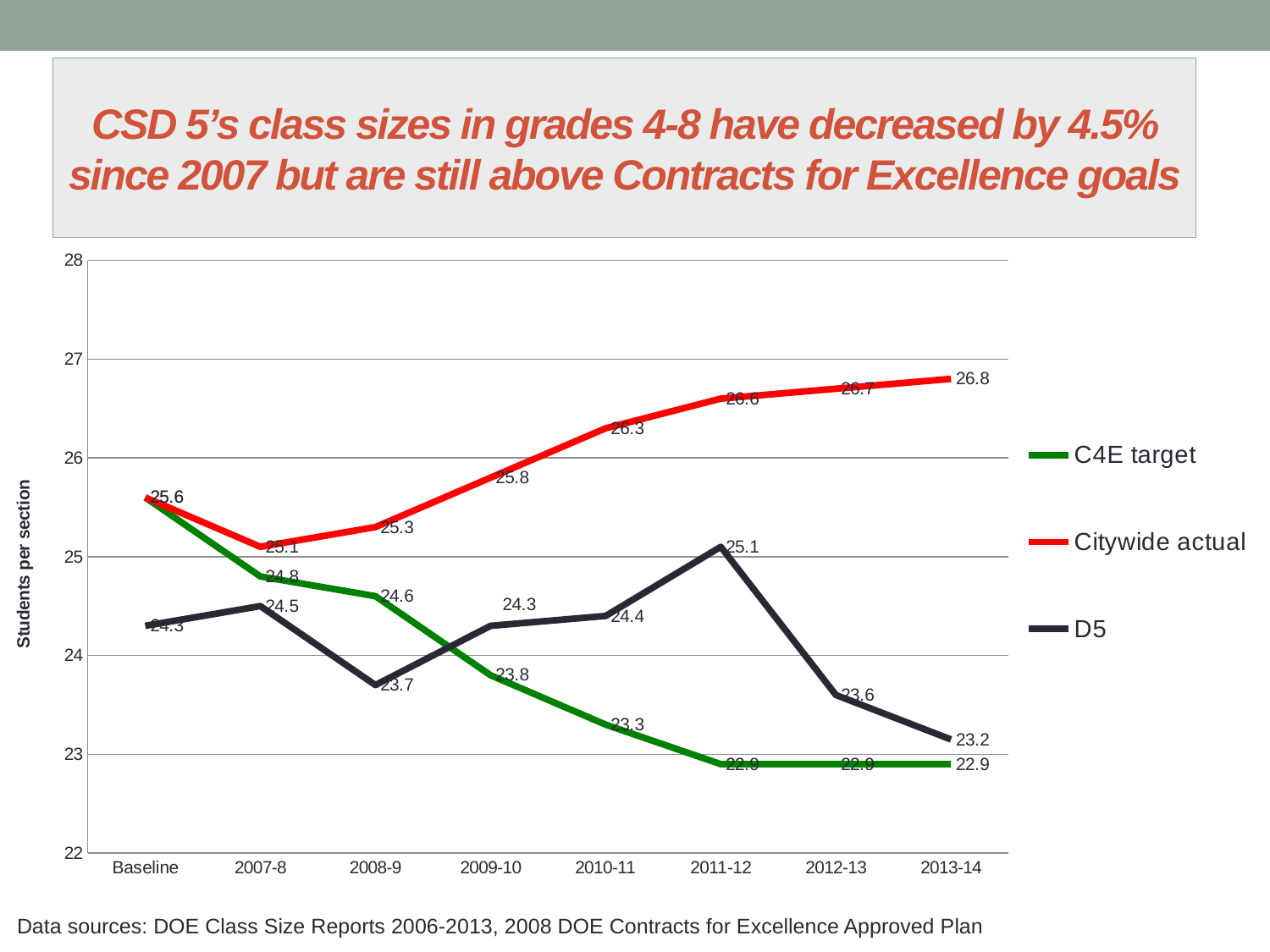
What kind of chart is shown on the slide? line chart What is the Citywide actual value for 2010-11? 26.3 What is the difference between the Citywide actual and the C4E target values in 2013-14? 3.9 What is the Citywide actual value for 2013-14? 26.8 How many points are plotted along the x axis for each series? 8 Which is larger in 2010-11, the D5 value or the C4E target value? D5 How many series does the legend list? 3 In which year is the D5 series at its lowest? 2013-14 In which year is the D5 series at its highest? 2011-12 Does the Citywide actual series rise or fall from 2007-8 to 2013-14? rise What is the D5 value for 2011-12? 25.1 What is the C4E target value for 2009-10? 23.8